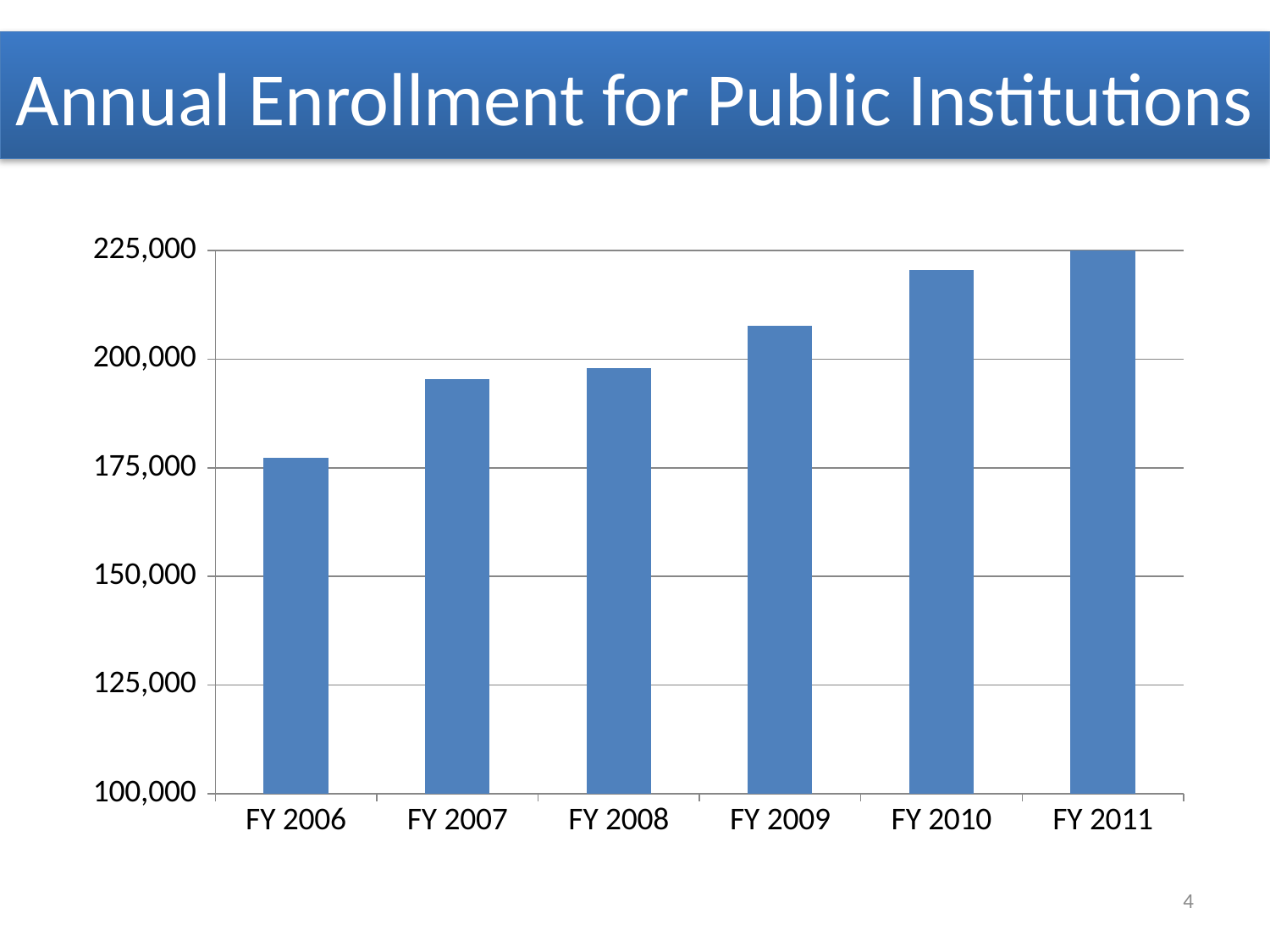
Is the value for FY 2007 greater or less than 200,000? less Which fiscal year has the highest enrollment? FY 2011 Which has the larger enrollment, FY 2008 or FY 2009? FY 2009 Which fiscal year has the lowest enrollment? FY 2006 Is the value for FY 2009 greater or less than 200,000? greater Is the value for FY 2010 greater or less than 225,000? less What is the title of the slide? Annual Enrollment for Public Institutions What is the lowest value shown on the vertical axis? 100,000 Do enrollment values rise or fall from FY 2006 to FY 2011? rise How many fiscal years are plotted on the chart? 6 What kind of chart is shown on the slide? bar chart